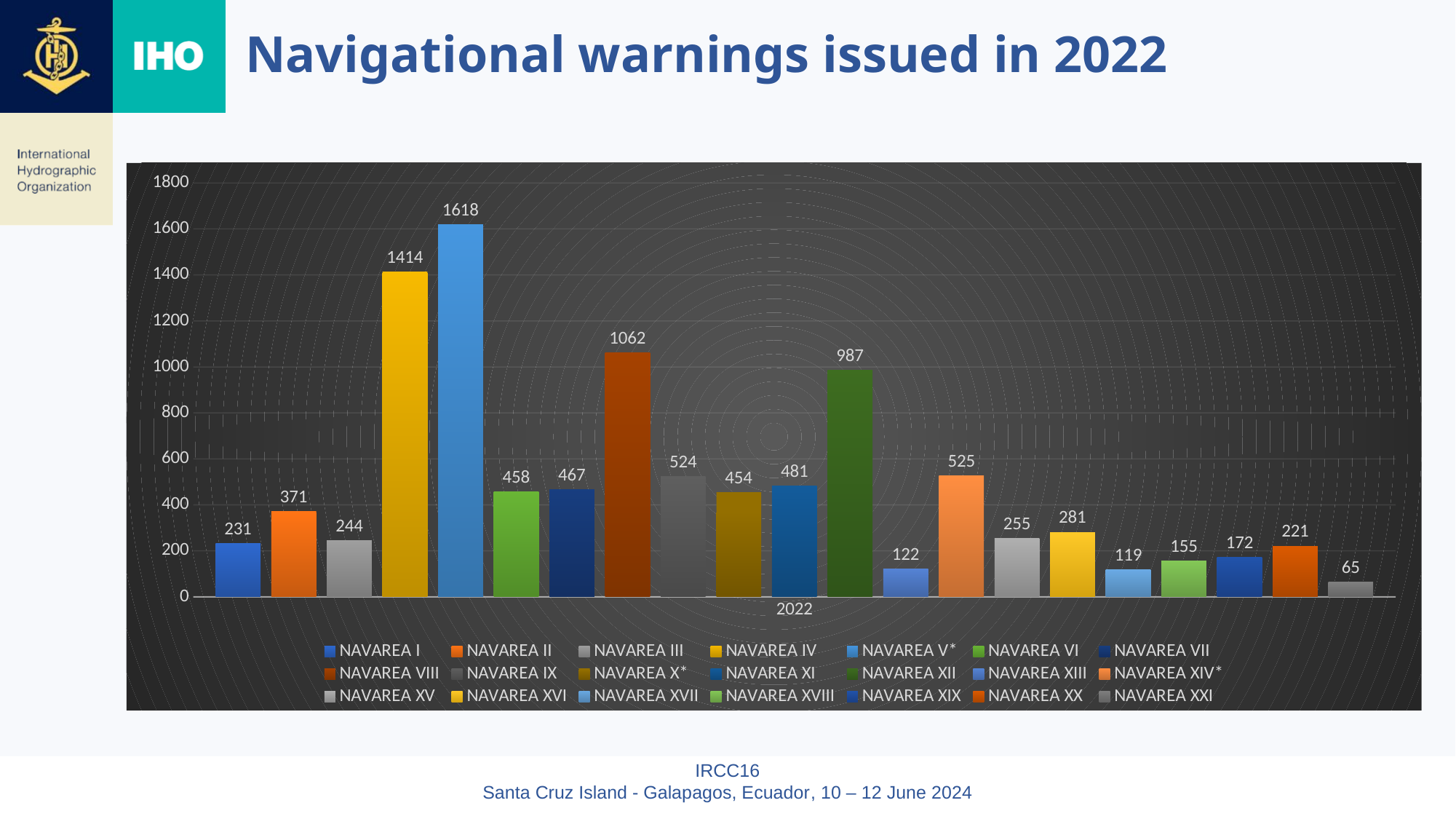
Which is larger, the value for NAVAREA II or the value for NAVAREA XVI? NAVAREA II What is the difference between the values for NAVAREA V* and NAVAREA IV? 204 What is the value shown for NAVAREA VIII? 1062 How many navigational warnings were issued by NAVAREA V* in 2022? 1618 What is the value shown for NAVAREA XXI? 65 What kind of chart is shown on the slide? Bar chart Which NAVAREA issued the most navigational warnings in 2022? NAVAREA V* How many series does the legend list? 21 What is the difference between the values for NAVAREA XII and NAVAREA VIII? 75 Which NAVAREA issued the fewest navigational warnings in 2022? NAVAREA XXI What is the title of the chart on the slide? Navigational warnings issued in 2022 Is the value for NAVAREA XII greater or less than 800? greater